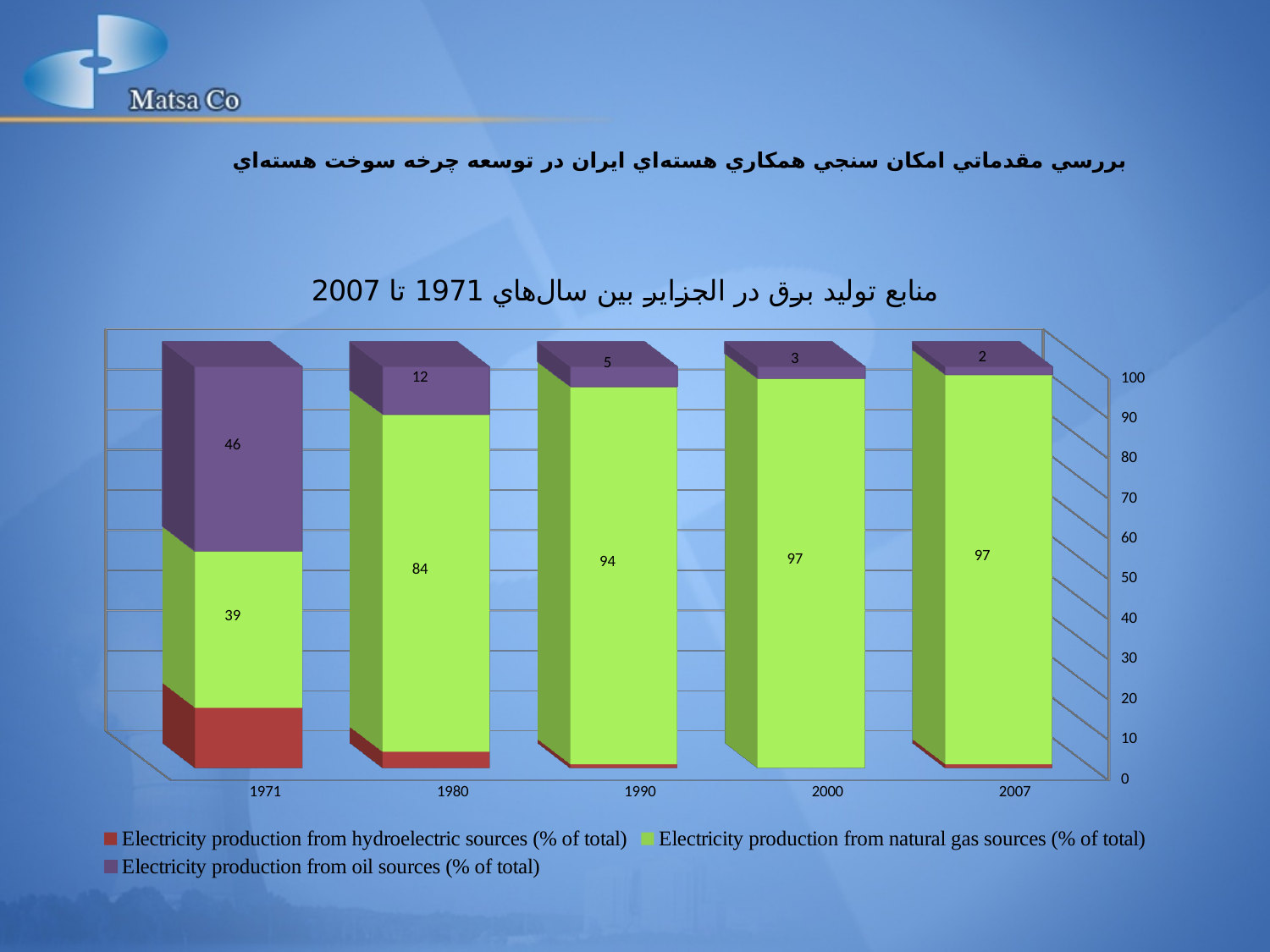
In which year is the oil share highest? 1971 Is the value for hydroelectric sources in 1971 greater or less than 30? less Does the oil share rise or fall from 1971 to 2007? Fall How many years are shown on the x axis? 5 What is the difference between the natural gas values for 1980 and 1971? 45 How many series does the legend list? 3 What is the value for natural gas sources in 1990? 94 What is the value for oil sources in 1971? 46 Which is larger in 1971: the natural gas share or the oil share? Oil sources What is the value for natural gas sources in 1980? 84 In which year is the natural gas share lowest? 1971 What is the value for oil sources in 2007? 2